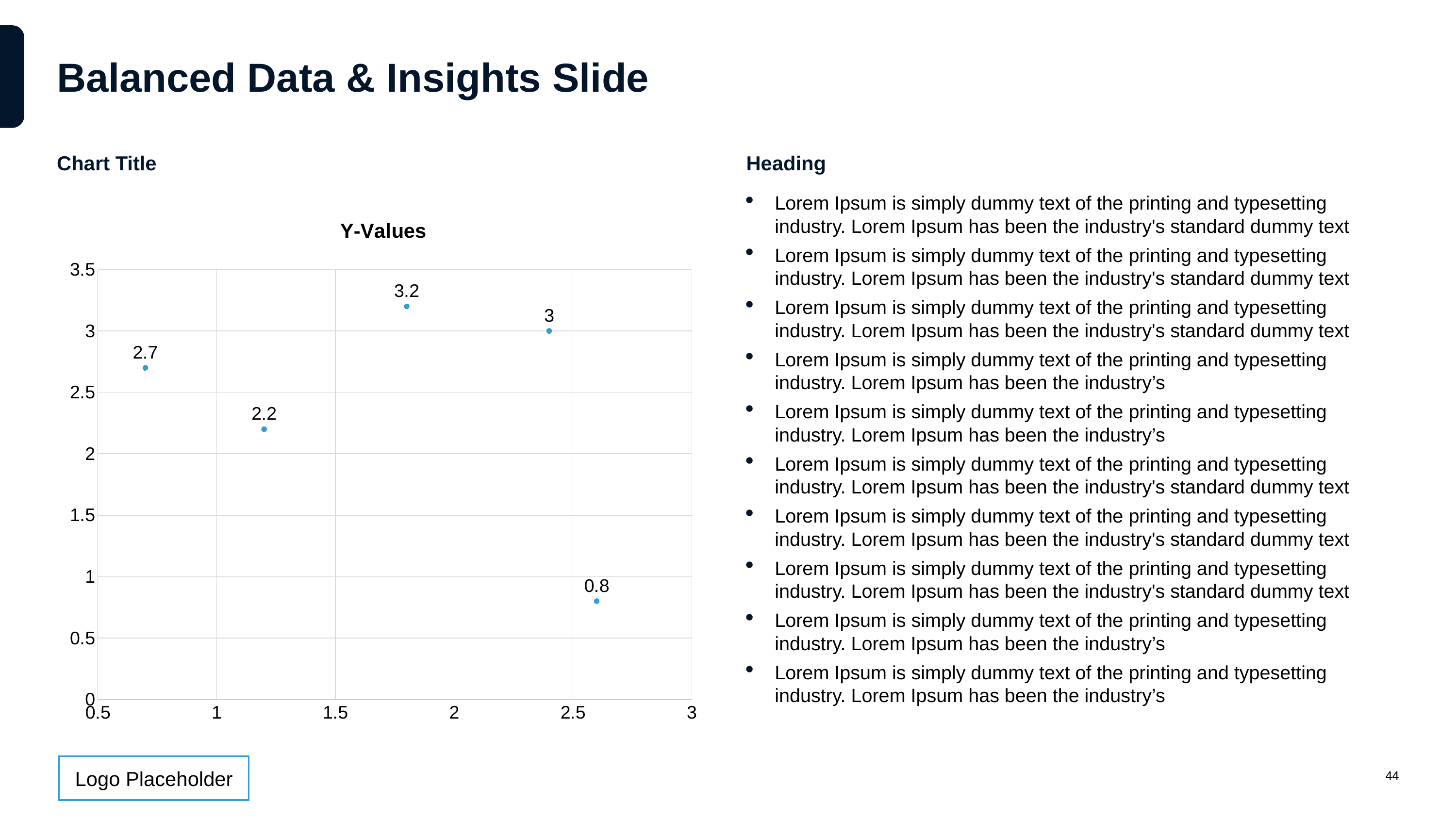
What is the title shown above the chart's plot area? Y-Values Which is larger: the leftmost data point or the second data point from the left? the leftmost data point What is the difference between the point labelled 3.2 and the point labelled 3? 0.2 Is the value of the rightmost data point greater or less than 1? less What is the highest data label value in the chart? 3.2 How many data points are plotted in the chart? 5 What is the lowest data label value in the chart? 0.8 What type of chart is shown on the slide? scatter chart What is the value of the leftmost data point in the chart? 2.7 What is the value of the rightmost data point in the chart? 0.8 What is the maximum value shown on the y axis of the chart? 3.5 What is the difference between the highest and lowest labelled values in the chart? 2.4